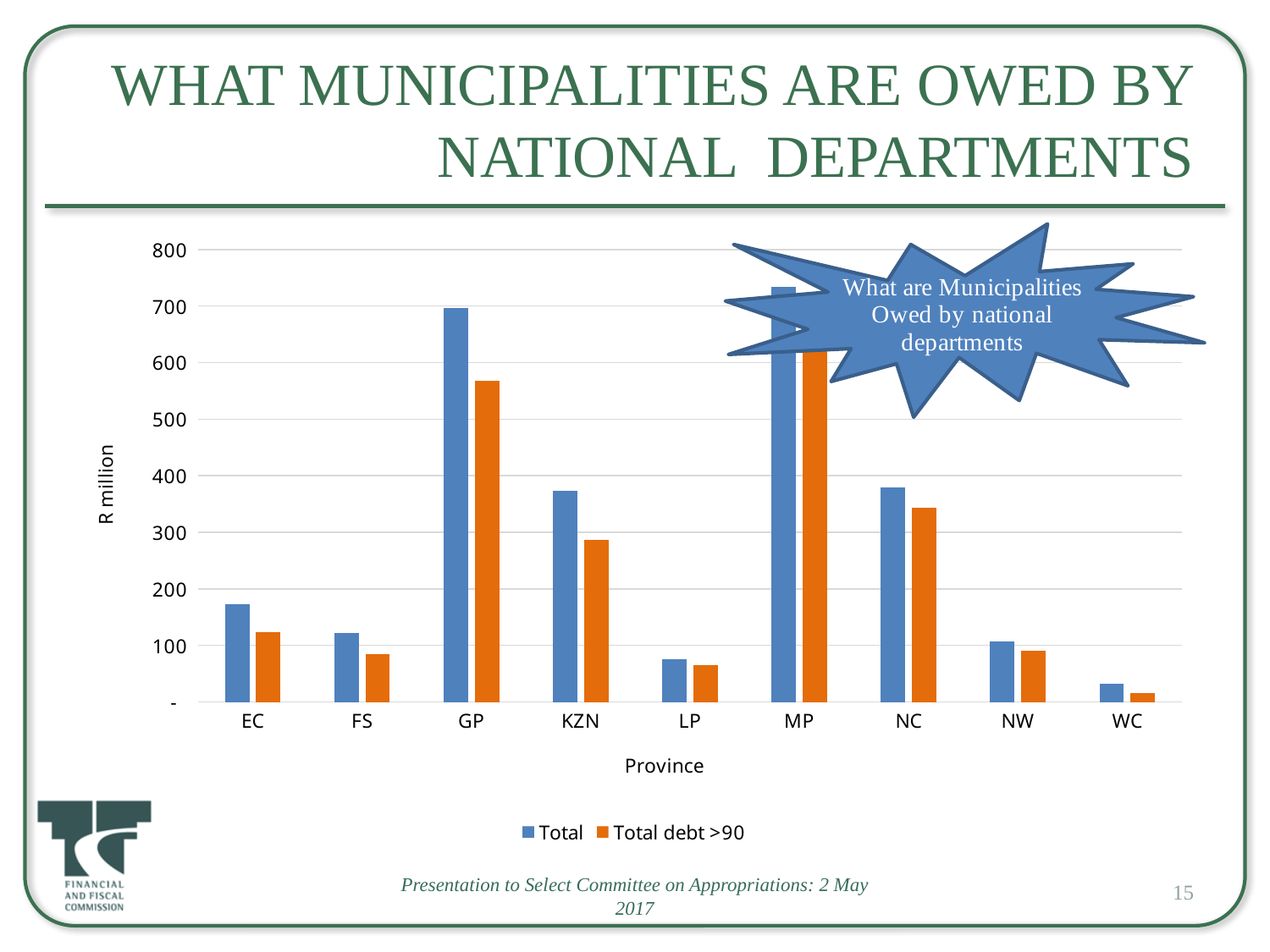
Which province has the lowest Total debt >90 value? WC What kind of chart is shown on the slide? bar chart Is the Total value for GP greater or less than 600? greater How many provinces are shown on the x axis of the chart? 9 Which province has the lowest Total value? WC What is the label on the vertical axis of the chart? R million Which province has the highest Total value? MP Which is larger, the Total value for EC or the Total value for FS? EC Is the Total debt >90 value for NC greater or less than 300? greater Is the Total value for LP greater or less than 100? less How many series does the chart's legend list? 2